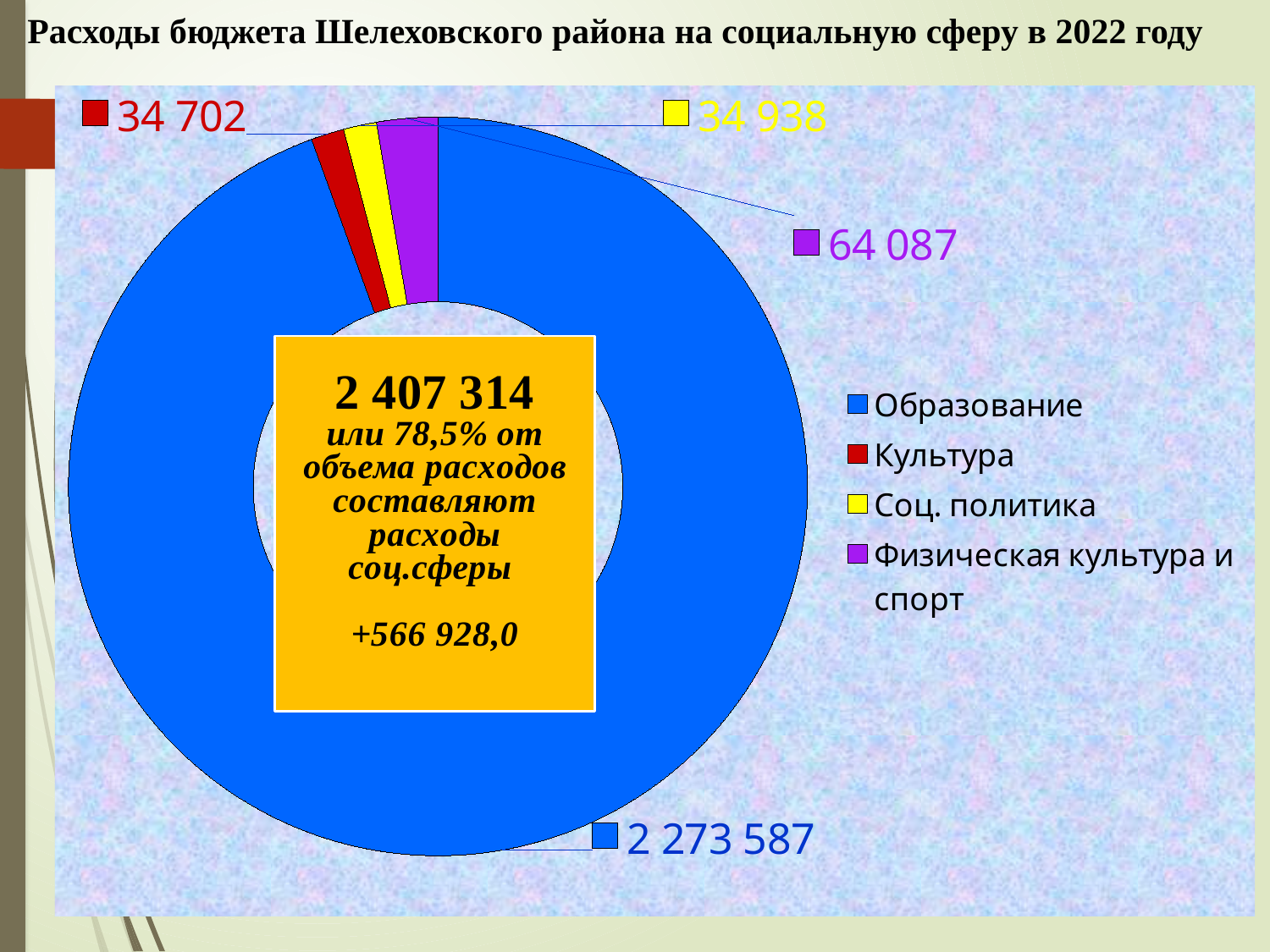
What is the value shown for Культура? 34 702 Which is larger, the value for Соц. политика or the value for Культура? Соц. политика What kind of chart is shown on the slide? Doughnut chart How many categories are shown in the chart? 4 What is the difference between the values for Соц. политика and Культура? 236 What is the value shown for Физическая культура и спорт? 64 087 Which category has the largest slice of the chart? Образование What is the value shown for Образование? 2 273 587 What total value is printed in the centre of the chart? 2 407 314 What is the difference between the values for Физическая культура и спорт and Соц. политика? 29 149 Which category has the smallest value in the chart? Культура What is the value shown for Соц. политика? 34 938